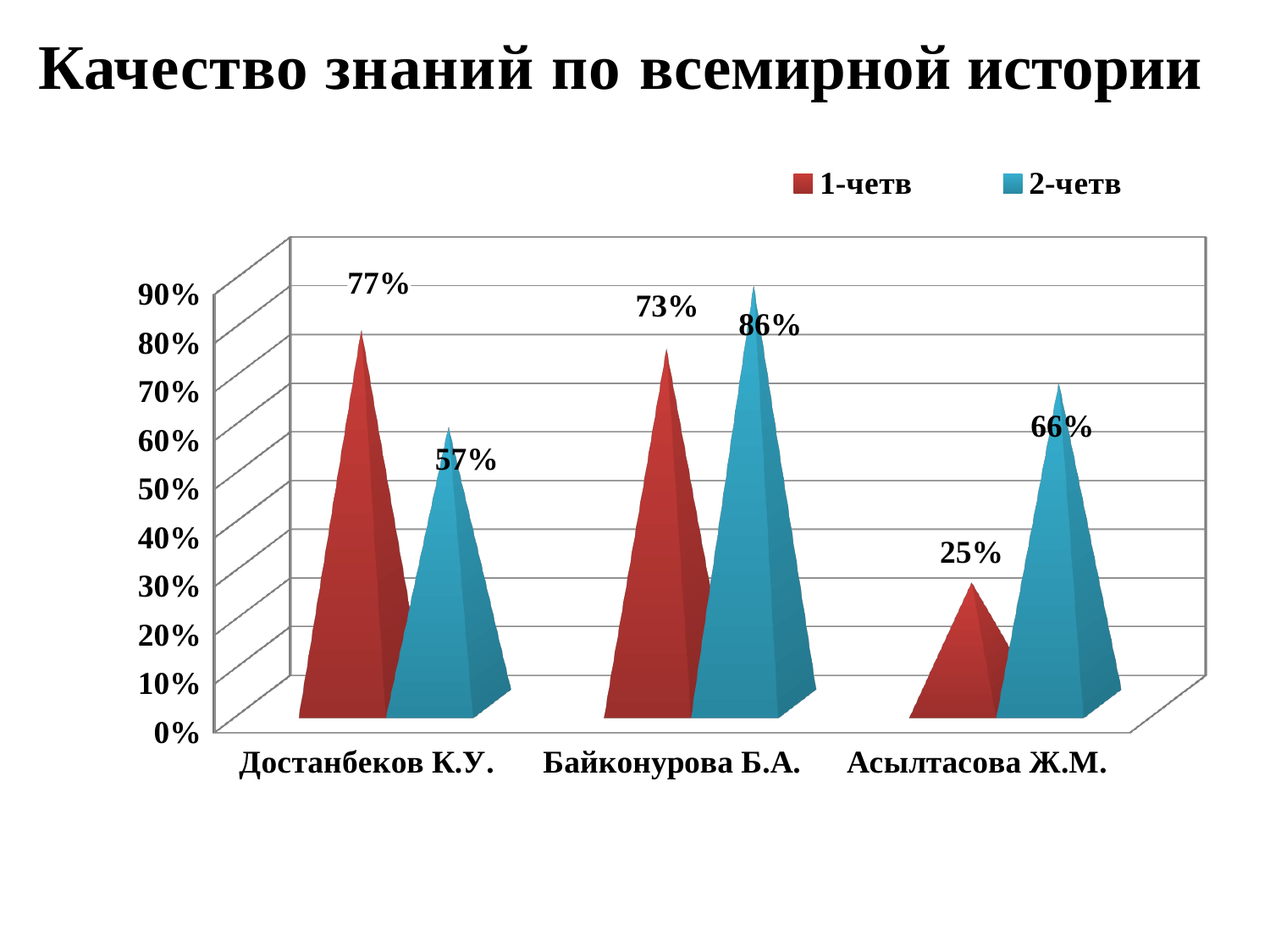
Which is larger for Достанбеков К.У.: the 1-четв value or the 2-четв value? 1-четв What is the title of the chart? Качество знаний по всемирной истории What kind of chart is shown on the slide? Bar chart What is the value for Достанбеков К.У. in the 2-четв series? 57% How many series does the legend list? 2 What is the value for Байконурова Б.А. in the 2-четв series? 86% Which category has the lowest value in the 1-четв series? Асылтасова Ж.М. What is the difference between the 2-четв and 1-четв values for Асылтасова Ж.М.? 41% How many categories are shown on the x axis? 3 What is the value for Достанбеков К.У. in the 1-четв series? 77% Which category has the highest value in the 2-четв series? Байконурова Б.А. What is the value for Асылтасова Ж.М. in the 1-четв series? 25%